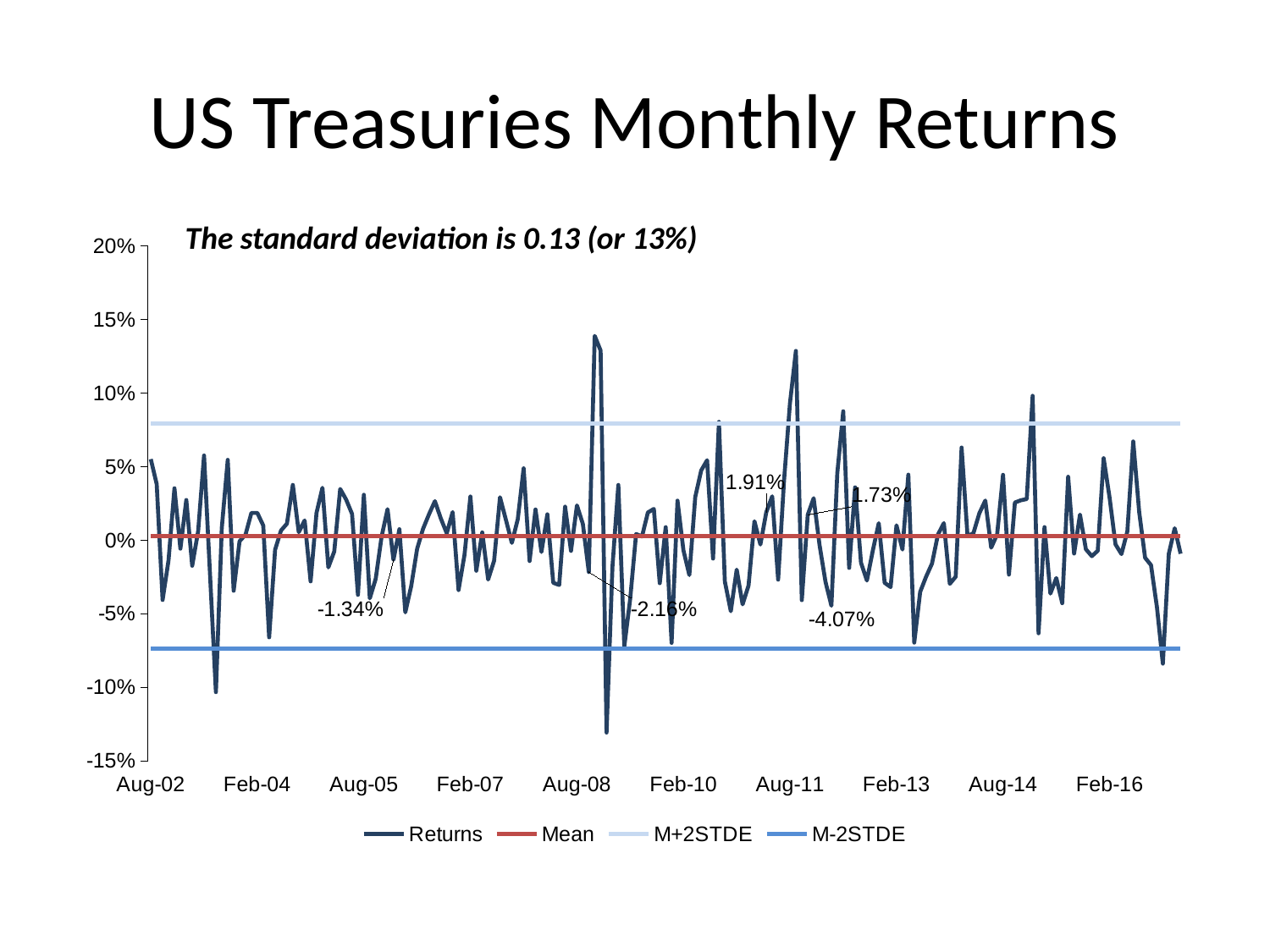
How many series does the legend list? 4 What is the smallest value among the data labels printed on the Returns line? -4.07% How many data labels are printed on the Returns line? 5 Is the Mean line greater or less than 5%? less Is the M-2STDE line greater or less than -5%? less What is the title of the chart? US Treasuries Monthly Returns What are the four series named in the legend? Returns, Mean, M+2STDE, M-2STDE What is the largest value among the data labels printed on the Returns line? 1.91% Is the highest peak of the Returns series, near Aug-08, greater or less than 10%? greater What kind of chart is shown on the slide? line chart